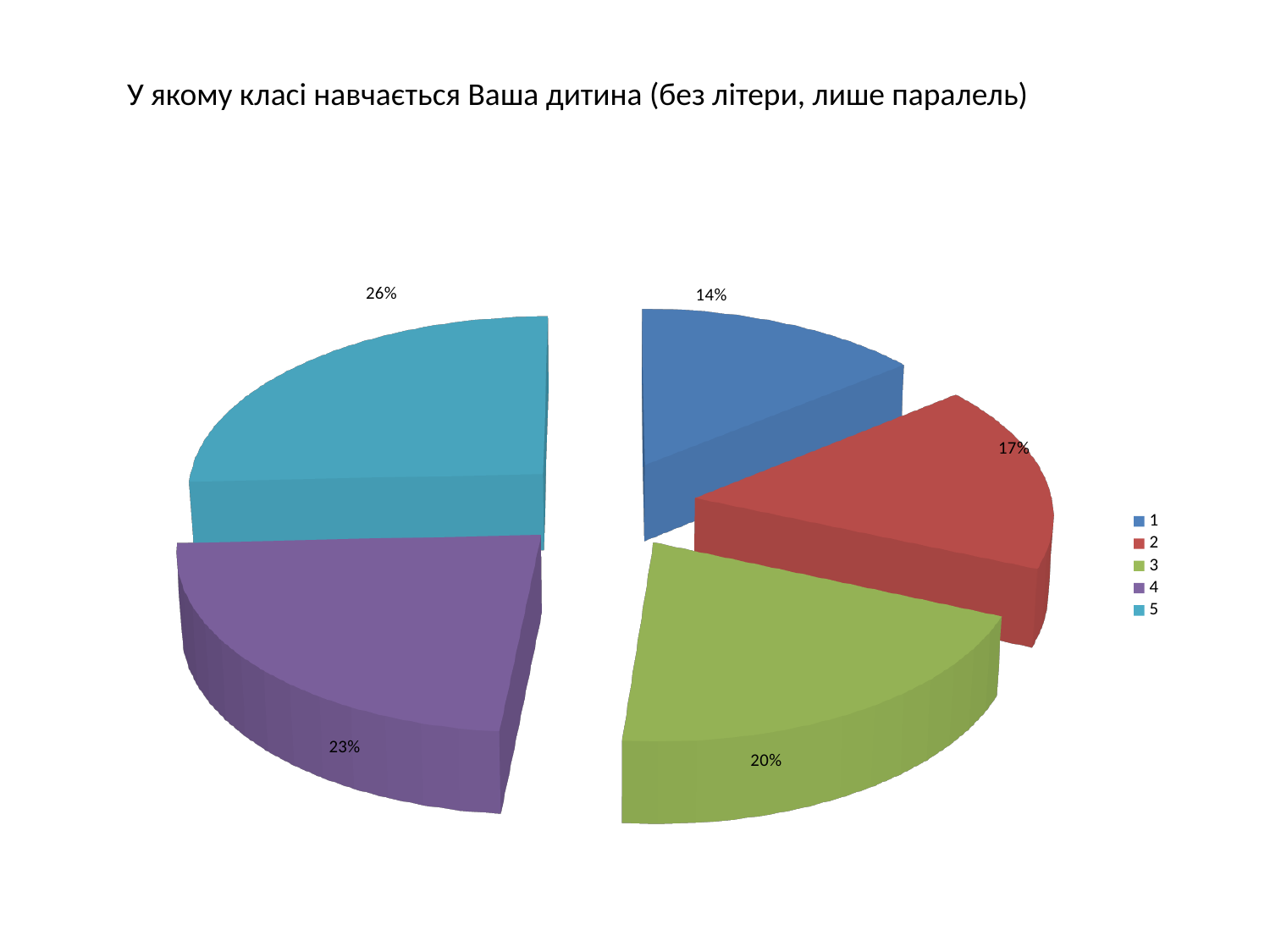
What share of the pie does category 1 have? 14% Which is larger, the slice for category 3 or the slice for category 2? 3 Which category has the largest slice of the pie? 5 How many categories does the legend list? 5 What kind of chart is shown on the slide? pie chart What share of the pie does category 4 have? 23% What share of the pie does category 5 have? 26% Which category has the smallest slice of the pie? 1 What is the difference in percentage points between category 5 and category 1? 12 What colour is the slice for category 4? purple